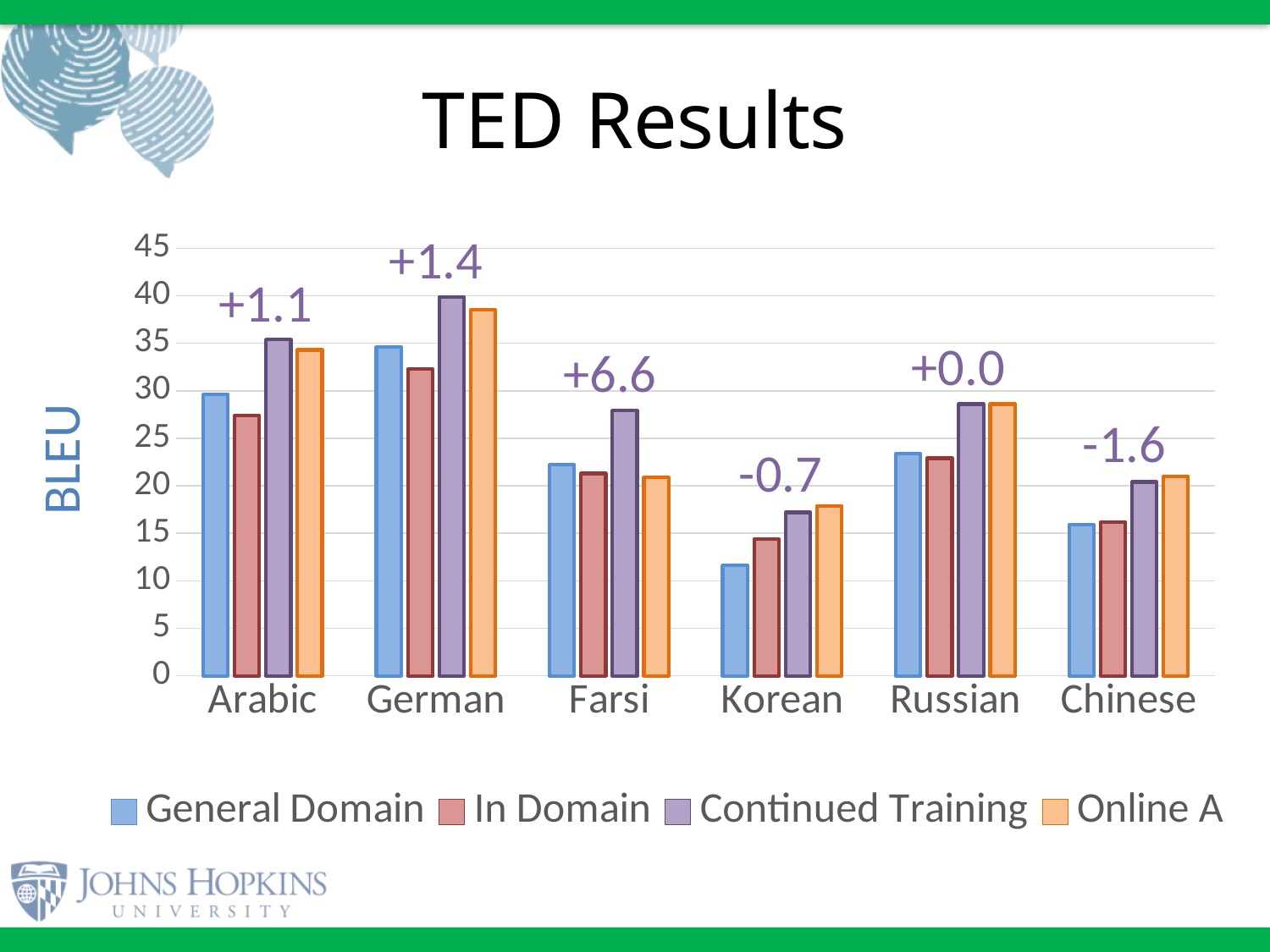
What is the label on the y axis of the chart? BLEU For Farsi, which is larger: the Continued Training bar or the Online A bar? Continued Training For Korean, which is larger: the General Domain bar or the In Domain bar? In Domain Which language has the lowest General Domain bar? Korean How many languages are shown on the x axis of the chart? 6 Is the General Domain value for Korean greater or less than 15? less What kind of chart is shown on the slide? bar chart How many series does the legend list? 4 Is the Continued Training value for German greater or less than 35? greater What value is printed above the Farsi group of bars? +6.6 Which language has the highest Continued Training bar? German Is the Continued Training value for Arabic greater or less than 30? greater